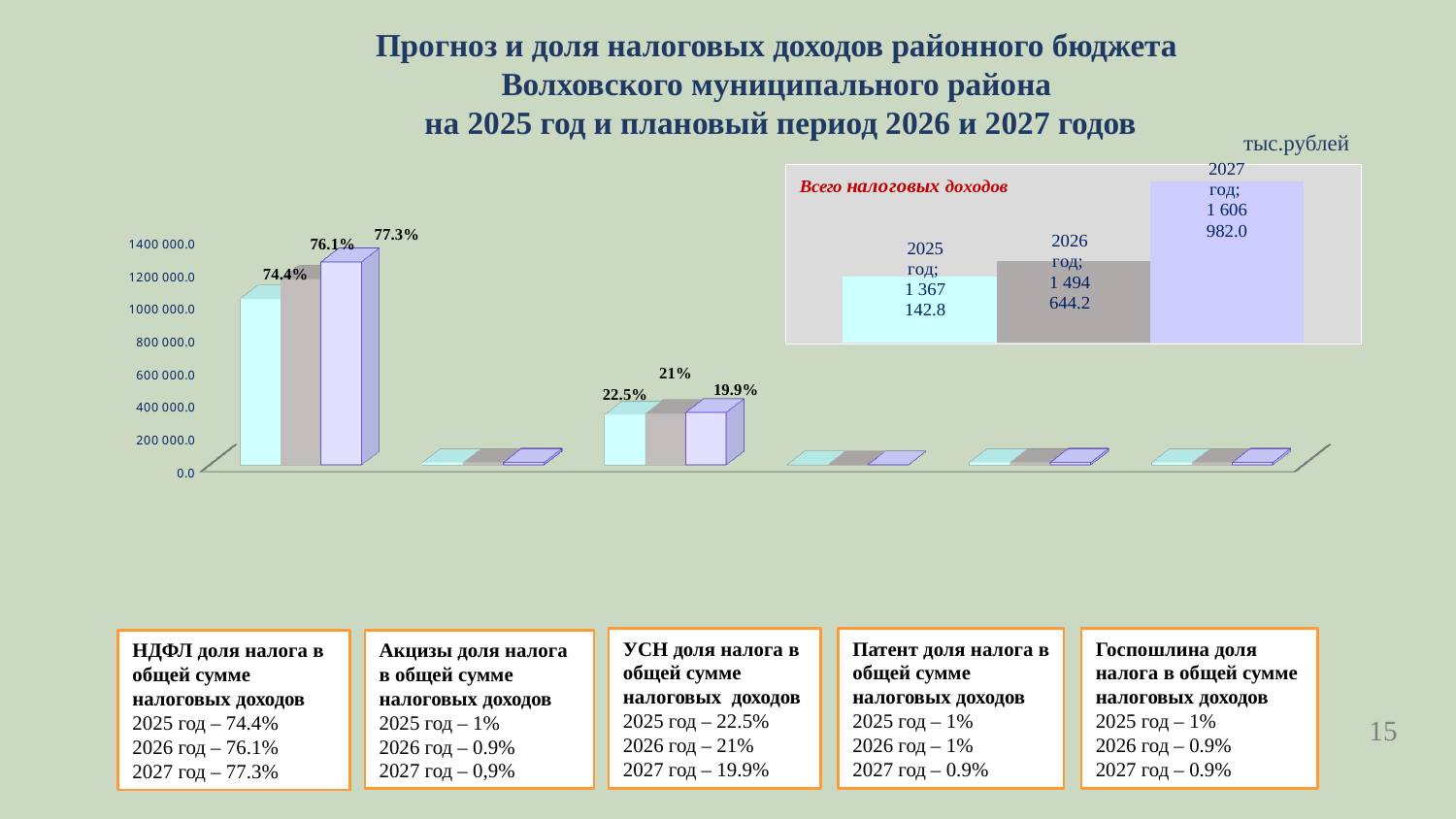
In the inset chart titled 'Всего налоговых доходов', which year has the highest value? 2027 год In the inset chart titled 'Всего налоговых доходов', which year has the lowest value? 2025 год In the inset chart titled 'Всего налоговых доходов', what is the value for 2025 год? 1 367 142.8 What kind of chart is the large chart on the left of the slide? bar chart In the inset chart titled 'Всего налоговых доходов', what is the value for 2026 год? 1 494 644.2 In the large chart on the left, what percentage label is shown on the first bar of the third group? 22.5% In the large chart on the left, what percentage label is shown on the tallest bar of the first group? 77.3% In the inset chart titled 'Всего налоговых доходов', how many bars are shown? 3 In the inset chart titled 'Всего налоговых доходов', what is the difference between the 2026 год and 2025 год values? 127 501.4 In the inset chart titled 'Всего налоговых доходов', what is the value for 2027 год? 1 606 982.0 In the inset chart titled 'Всего налоговых доходов', do the values rise or fall from 2025 to 2027? rise In the large chart on the left, is the value of the tallest bar in the first group greater or less than 1400 000.0? less